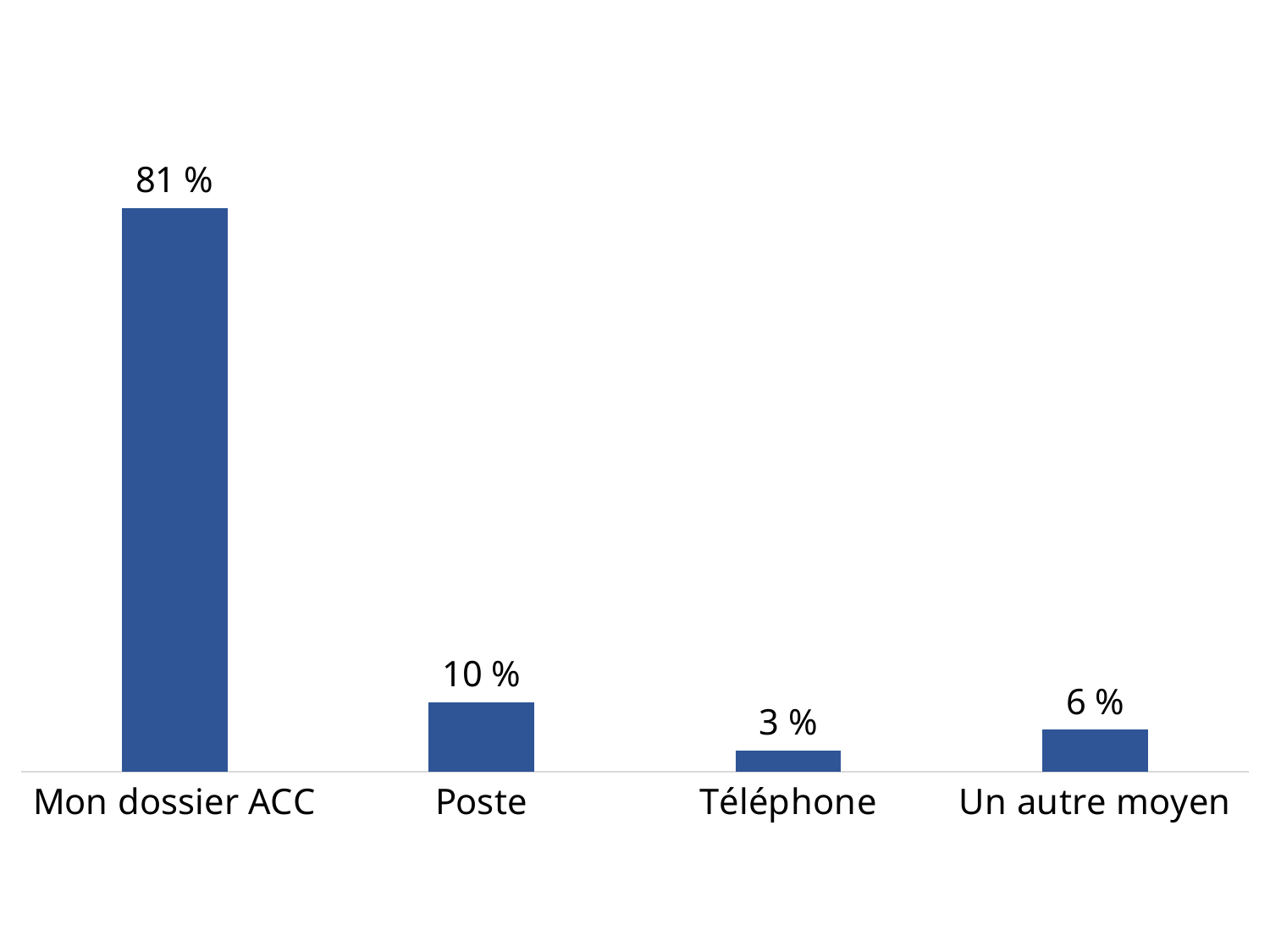
What is the value for Poste? 10 % How many categories are shown in the chart? 4 What is the value for Un autre moyen? 6 % What is the difference between the values for Mon dossier ACC and Poste? 71 % Which category has the highest value? Mon dossier ACC What is the difference between the values for Un autre moyen and Téléphone? 3 % Which category has the lowest value? Téléphone Which is larger, the value for Poste or the value for Un autre moyen? Poste What is the value for Mon dossier ACC? 81 % What is the value for Téléphone? 3 % What kind of chart is this? Bar chart What colour are the bars in the chart? Blue